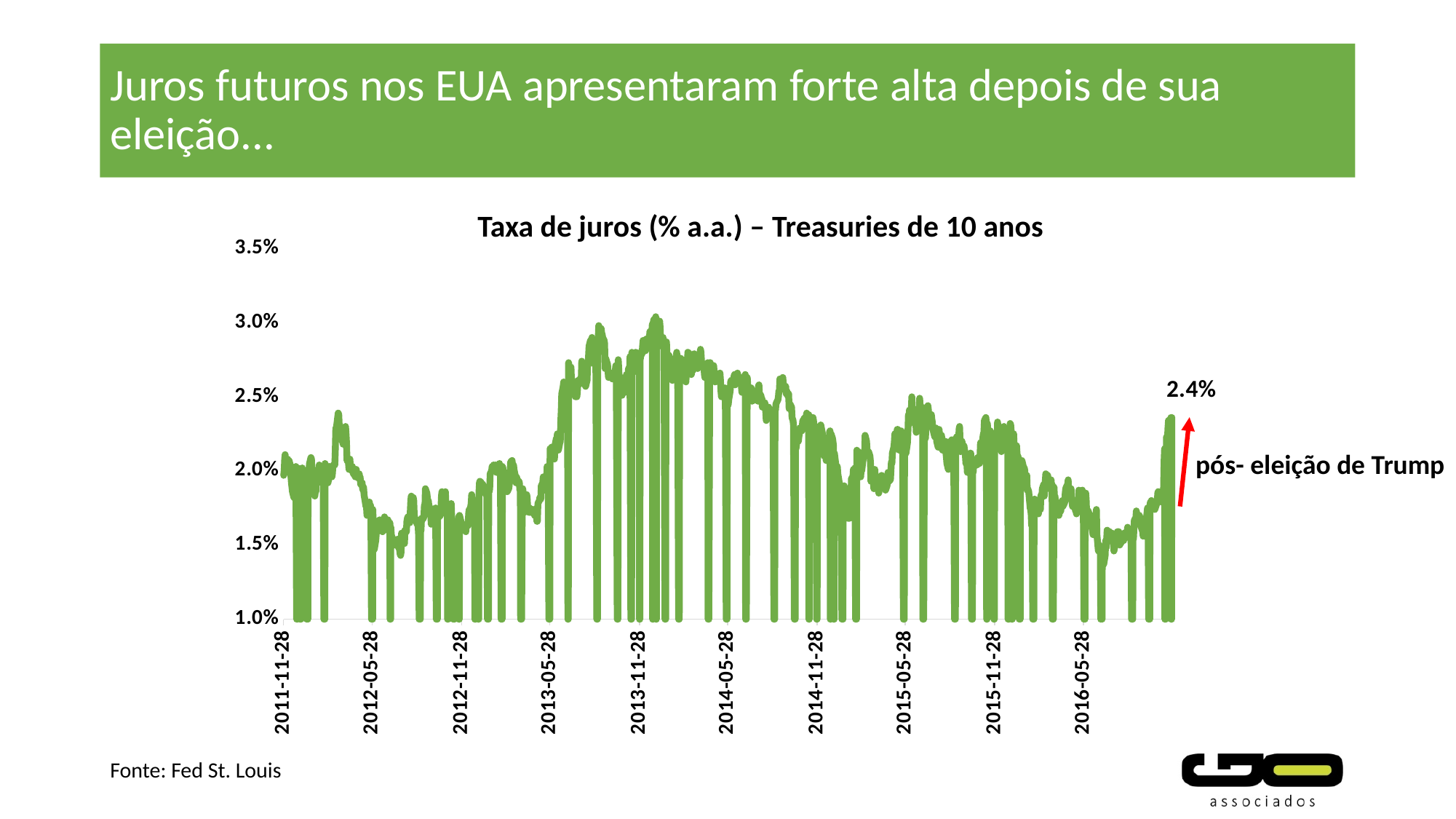
Does the series rise or fall between 2013-11-28 and 2014-11-28? fall Is the value around 2016-05-28 greater or less than 2.0%? less Does the series rise or fall from 2016-05-28 to the end of the chart? rise Is the peak of the series around early 2014 greater or less than 2.5%? greater Which is larger: the value at the end of the series or the value around 2016-05-28? the value at the end of the series What is the first date label on the x axis? 2011-11-28 What value is labelled at the end of the series, after the Trump election? 2.4% What kind of chart is shown on the slide? line chart How many date labels are shown on the x axis? 10 Is the final labelled value of the series greater or less than 2.0%? greater What is the highest value shown on the y axis? 3.5% What is the title of the chart? Taxa de juros (% a.a.) – Treasuries de 10 anos